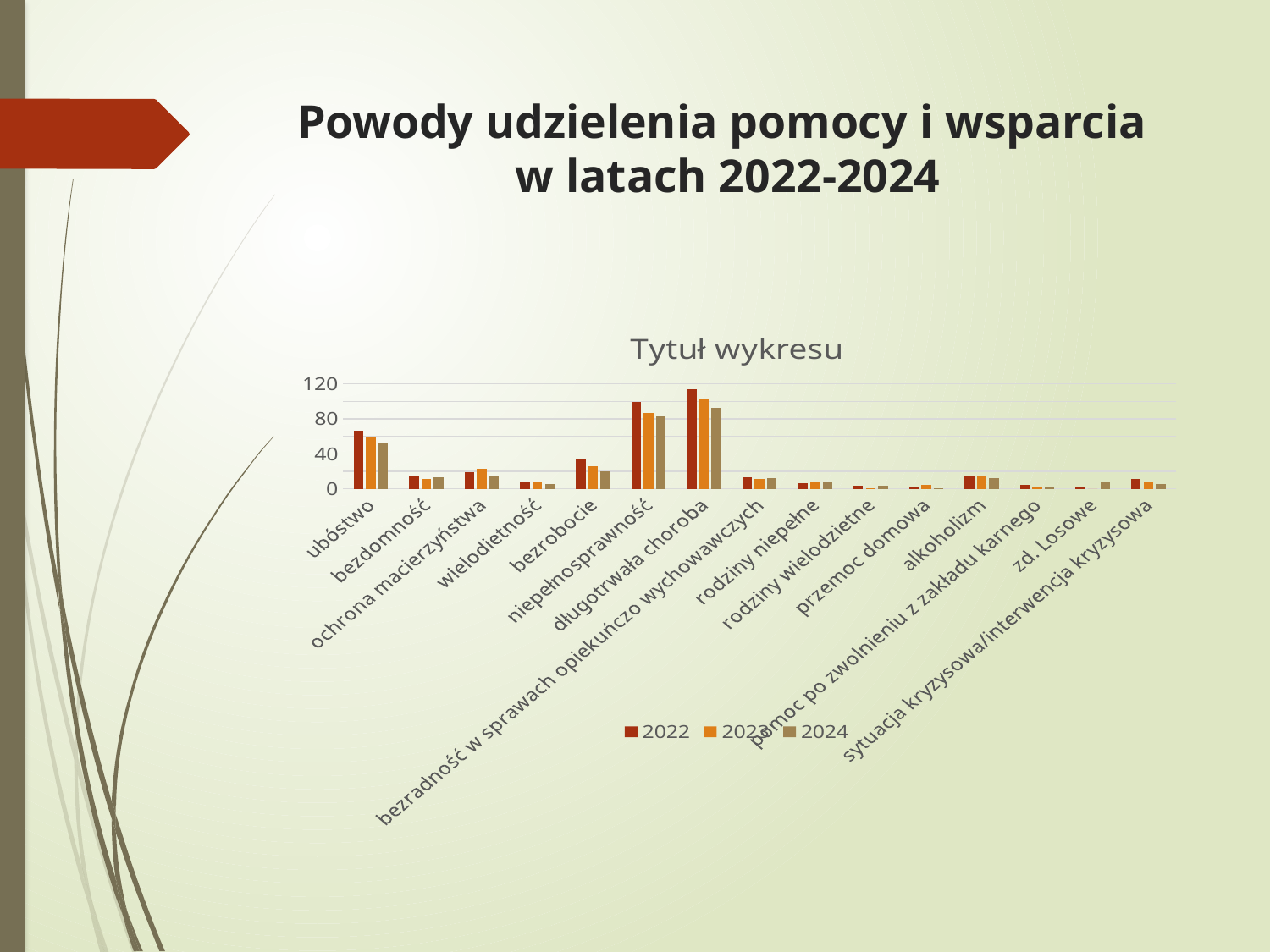
How many series does the chart legend list? 3 What kind of chart is shown on the slide? bar chart Is the 2022 value for bezrobocie greater or less than 40? less Is the 2022 value for długotrwała choroba greater or less than 80? greater Is the 2022 value for niepełnosprawność greater or less than 80? greater Do the values for długotrwała choroba rise or fall from 2022 to 2024? fall Which is larger, the 2022 value for ubóstwo or the 2022 value for bezdomność? ubóstwo What is the title shown above the chart? Tytuł wykresu Which series is shown in dark red in the chart legend? 2022 How many categories are shown on the x axis of the chart? 15 Which category has the highest bar in the chart? długotrwała choroba